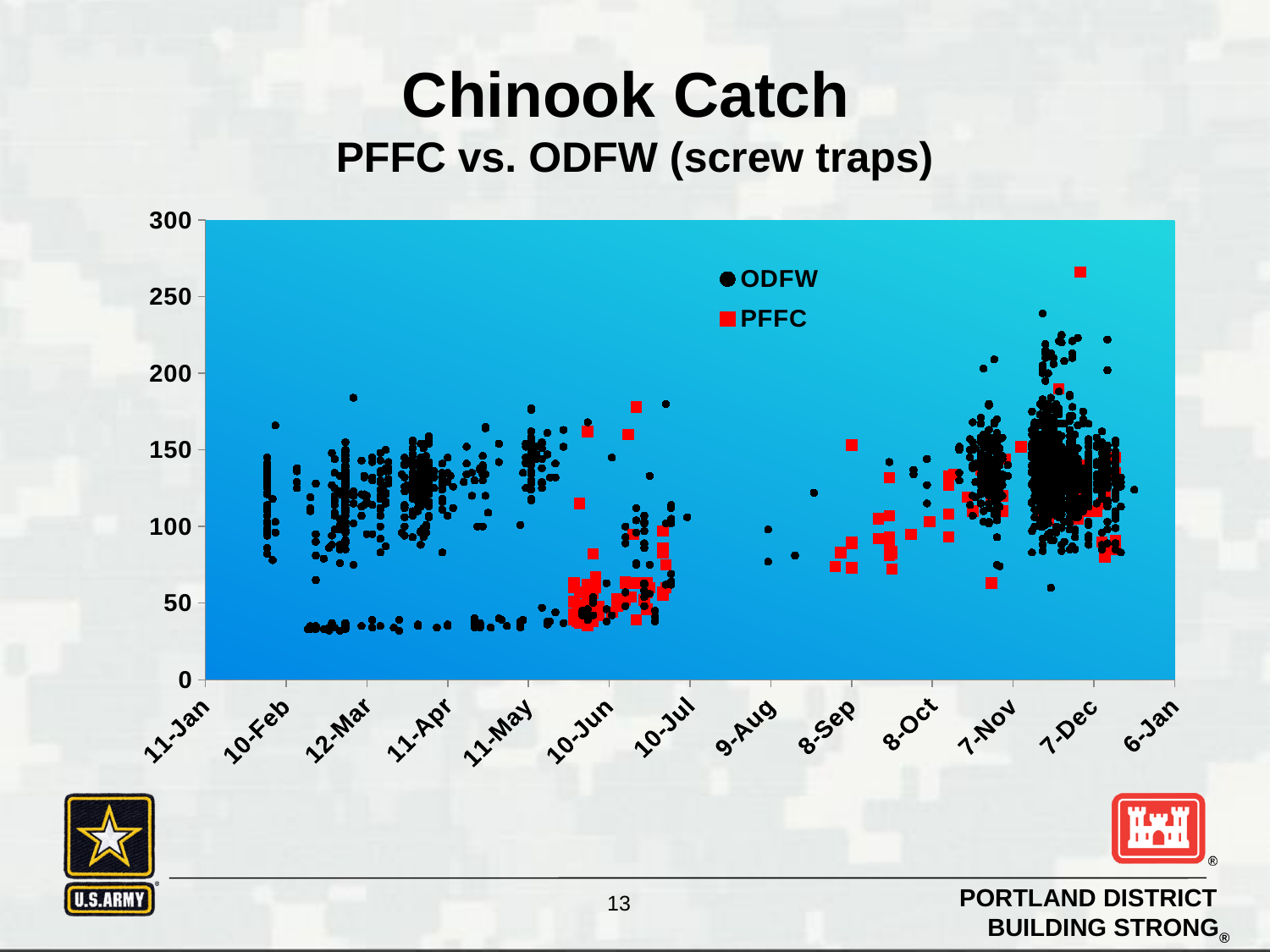
What colour are the PFFC markers? Red Which x-axis label is the first one shown on the left? 11-Jan Is the highest PFFC value plotted near 10-Jun greater or less than 200? less What is the highest value shown on the y axis? 300 Is the highest ODFW value greater or less than 250? less What are the two series named in the legend? ODFW and PFFC What kind of chart is shown on the slide? Scatter chart Are the lowest ODFW values plotted between 10-Feb and 10-Jun greater or less than 50? less How many series does the legend list? 2 Which series contains the single highest plotted point? PFFC How many date labels are shown along the x axis? 13